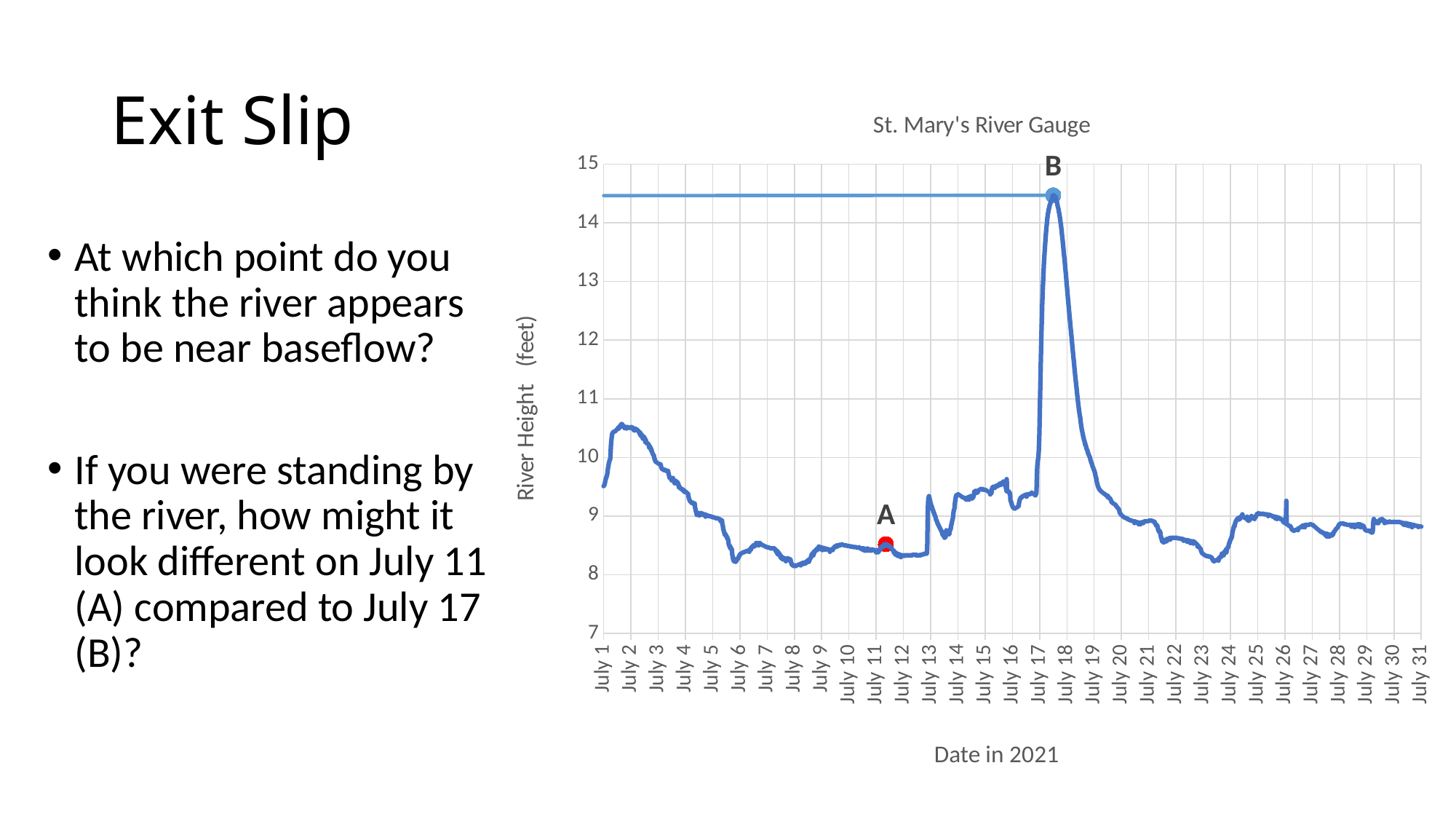
Between July 2 and July 6, does the river height rise or fall? fall How many dates are labeled along the x axis of the chart? 31 Is the river height at point B greater or less than 14? greater What is the label on the vertical axis of the chart? River Height (feet) Is the river height on July 2 greater or less than 10? greater Between July 18 and July 20, does the river height rise or fall? fall Which point shows a higher river height, A or B? B On which date does the river height reach its highest value? July 17 Is the river height on July 31 greater or less than 9? less What is the title of the chart? St. Mary's River Gauge What kind of chart is shown on the slide? line chart